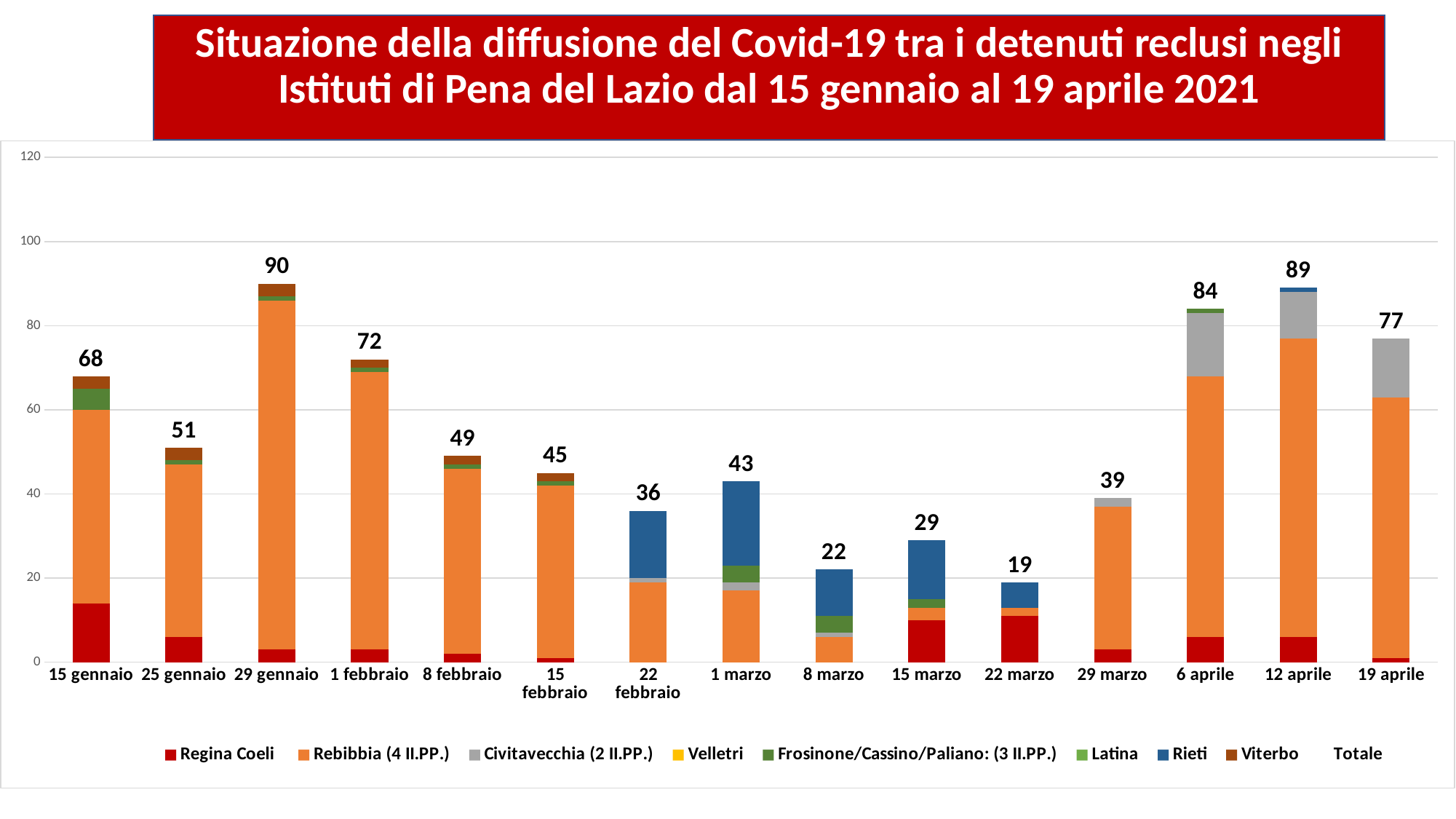
How many dates are shown on the x axis? 15 Which date has the highest total? 29 gennaio Is the Regina Coeli value for 15 gennaio greater or less than 20? less What is the difference between the totals for 12 aprile and 6 aprile? 5 What is the difference between the totals for 29 gennaio and 22 marzo? 71 What is the total value shown for 22 febbraio? 36 Do the totals rise or fall from 29 gennaio to 22 marzo? fall How many entries does the legend list? 9 Which date has the lowest total? 22 marzo Which total is larger, 15 gennaio or 1 febbraio? 1 febbraio What is the total value shown for 29 gennaio? 90 What kind of chart is shown on the slide? stacked bar chart